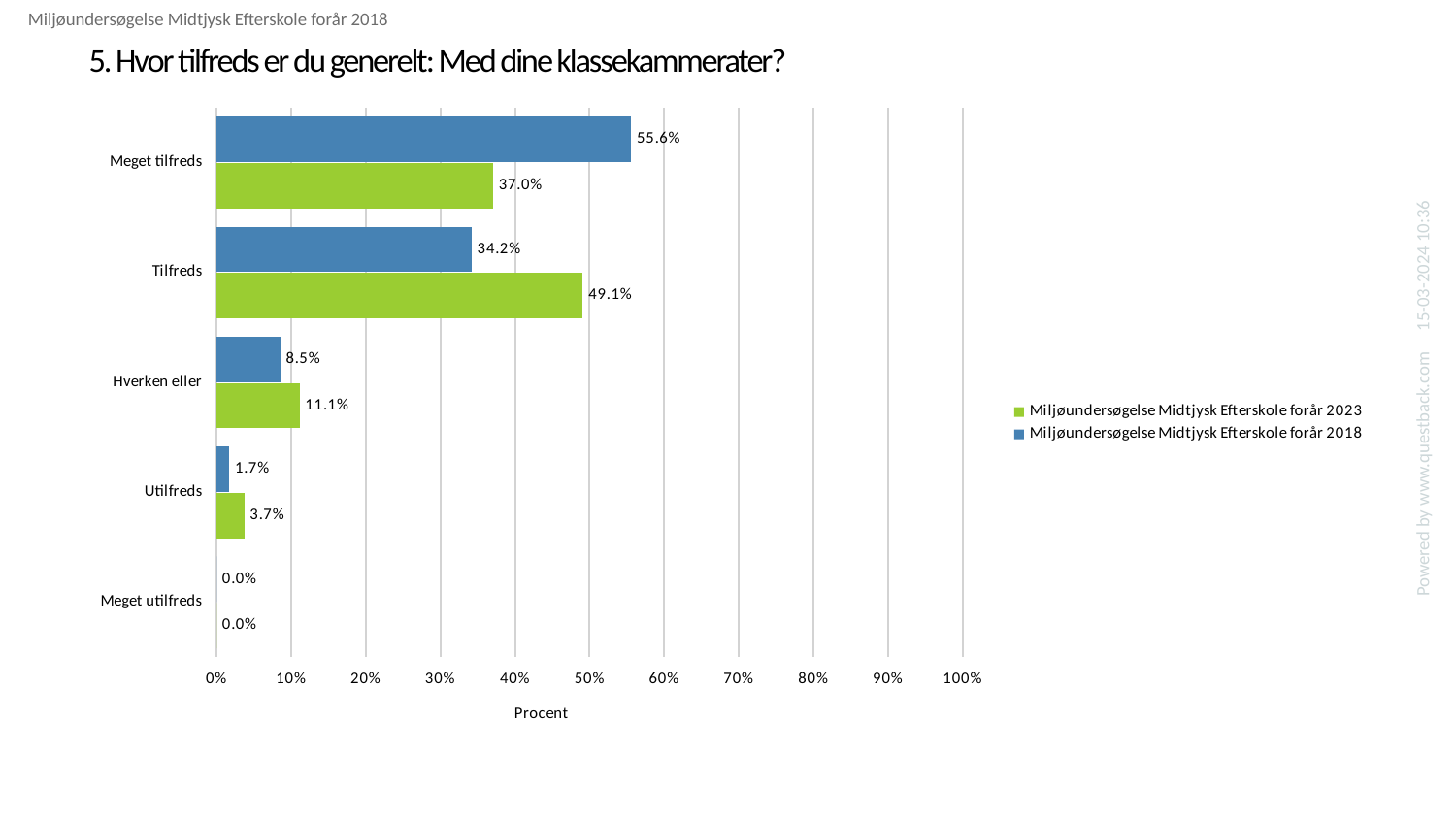
What is the value for "Utilfreds" in the 2023 series? 3.7% What is the value for "Tilfreds" in the 2023 series (Miljøundersøgelse Midtjysk Efterskole forår 2023)? 49.1% What is the value for "Meget tilfreds" in the 2018 series (Miljøundersøgelse Midtjysk Efterskole forår 2018)? 55.6% How many categories are shown on the vertical axis? 5 How many series does the legend list? 2 Which category has the highest value in the 2018 series? Meget tilfreds What is the value for "Hverken eller" in the 2018 series? 8.5% What kind of chart is shown on the slide? Bar chart What is the difference between the 2018 and 2023 values for "Meget tilfreds"? 18.6% Which category has the highest value in the 2023 series? Tilfreds For "Tilfreds", which series has the larger value, 2018 or 2023? 2023 What is the label of the horizontal axis? Procent